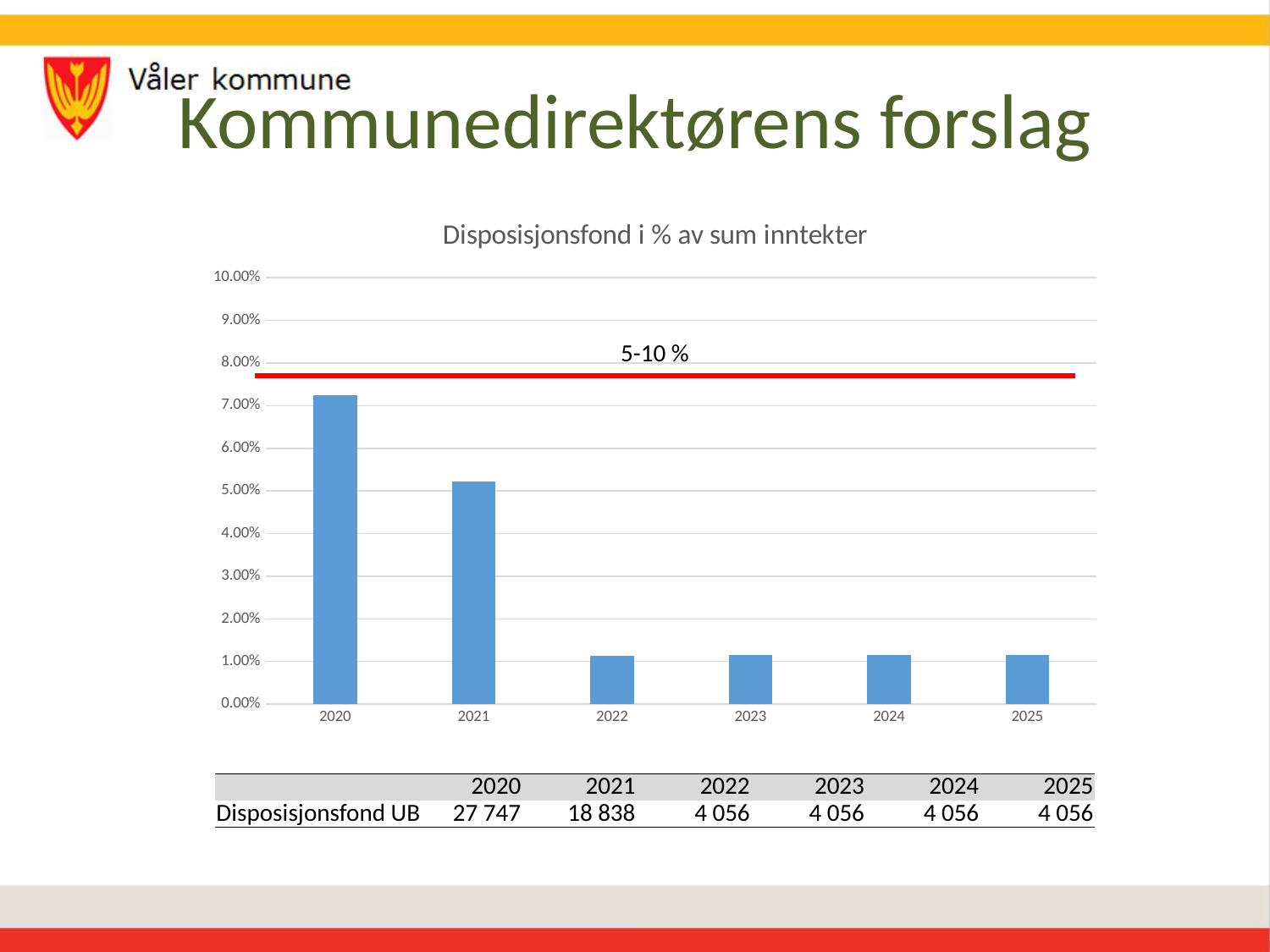
Which year has the highest value in the chart? 2020 How many years are shown on the x axis of the chart? 6 What type of chart is shown on the slide? bar chart Which is larger, the value for 2021 or the value for 2022? 2021 Do the values generally rise or fall from 2020 to 2025? fall Is the value for 2021 greater or less than 4.00%? greater Is the value for 2025 greater or less than 3.00%? less What is the title of the chart? Disposisjonsfond i % av sum inntekter Is the value for 2020 greater or less than 6.00%? greater Which is larger, the value for 2020 or the value for 2021? 2020 What label is written above the red horizontal line in the chart? 5-10 %